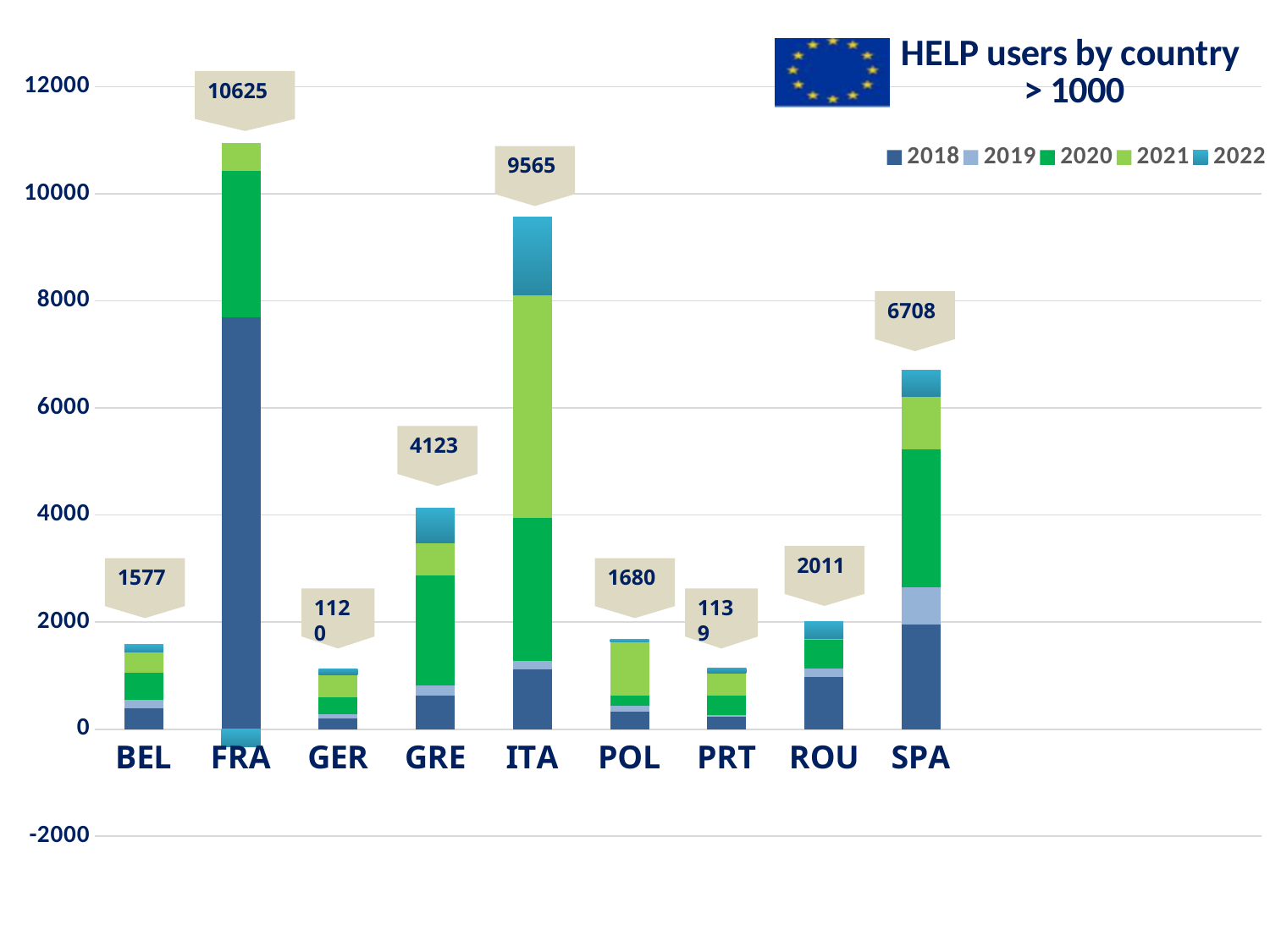
What is the total number of HELP users labelled for ITA? 9565 Which has a larger total of HELP users, GRE or SPA? SPA How many series does the legend list? 5 What is the difference between the labelled totals for FRA and ITA? 1060 What is the total number of HELP users labelled for FRA? 10625 How many countries are shown on the x axis of the chart? 9 What is the total number of HELP users labelled for ROU? 2011 Which country has the highest total of HELP users? FRA Is the total value for POL greater or less than 2000? less What is the total number of HELP users labelled for BEL? 1577 What kind of chart is shown on the slide? bar chart What is the difference between the labelled totals for SPA and GRE? 2585